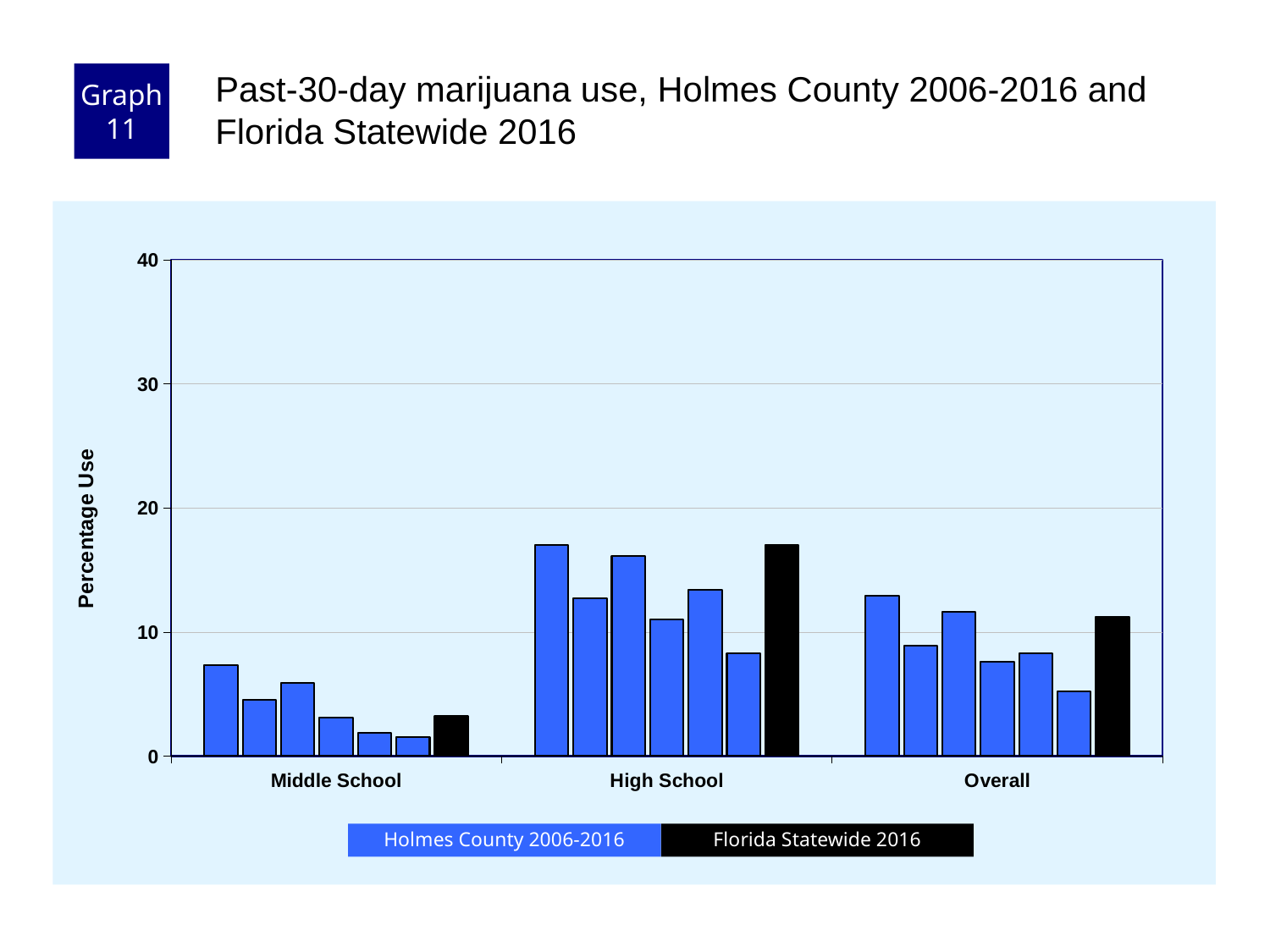
Is the Florida Statewide 2016 value for Overall greater or less than 20? less Is the Florida Statewide 2016 value for Middle School greater or less than 10? less Which colour represents Florida Statewide 2016 in the legend? black What kind of chart is shown on the slide? bar chart Which category has the highest bars overall? High School Which category has the lowest bars overall? Middle School Is the Florida Statewide 2016 value for High School greater or less than 10? greater What is the title of the y axis? Percentage Use How many series does the legend list? 2 Which is larger: the Florida Statewide 2016 value for High School or for Middle School? High School How many categories are shown on the x axis? 3